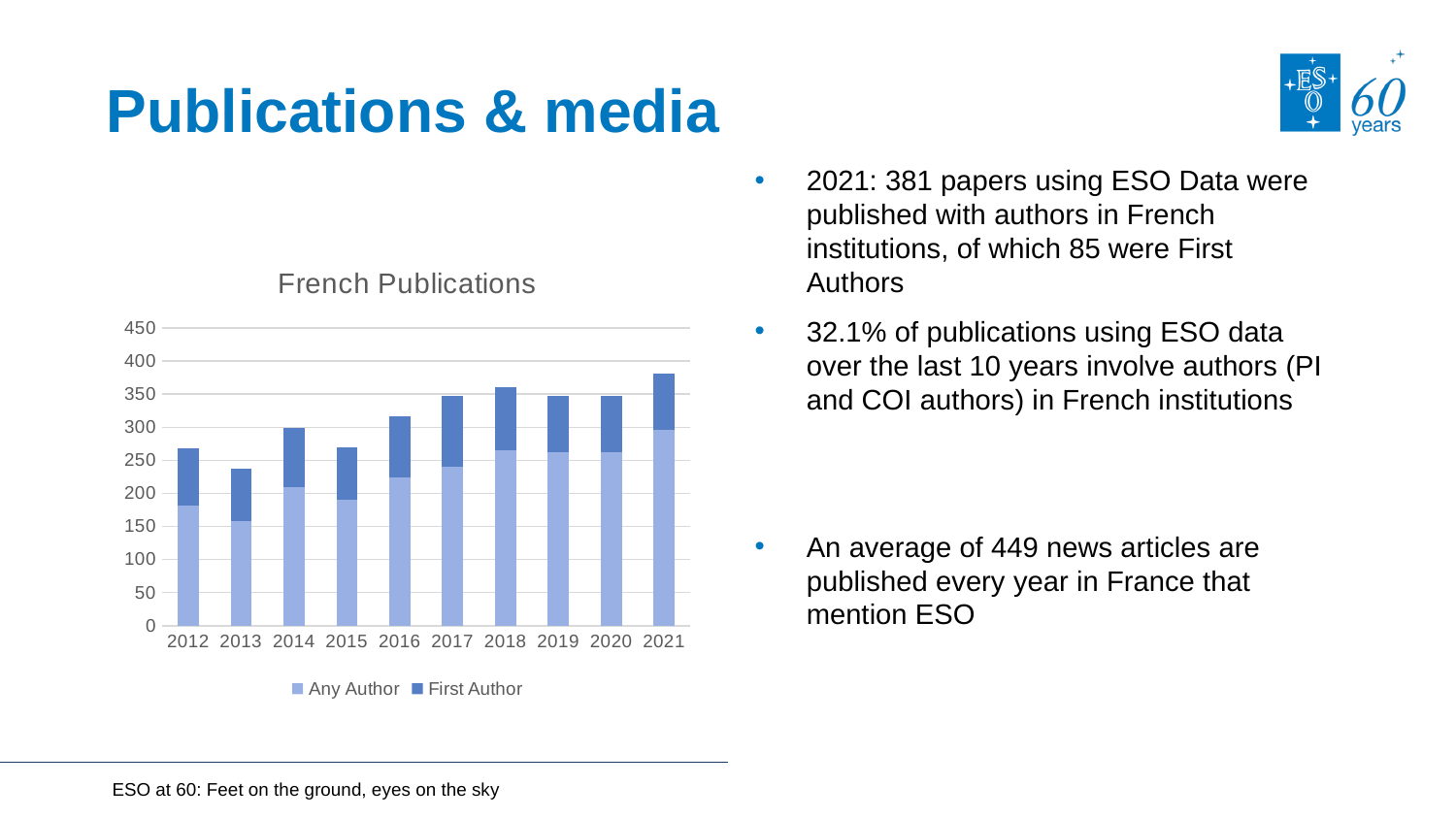
What kind of chart is shown on the slide? Stacked bar chart Is the total bar for 2016 greater or less than 300? greater Which year has the larger total bar, 2013 or 2015? 2015 Is the total bar for 2021 greater or less than 350? greater What is the title of the chart? French Publications Which year has the highest total bar in the chart? 2021 What are the two series named in the legend? Any Author and First Author Is the total bar for 2013 greater or less than 250? less How many years are shown on the x axis of the chart? 10 Do the total bars generally rise or fall from 2012 to 2021? rise How many series does the chart's legend list? 2 Which year has the lowest total bar in the chart? 2013